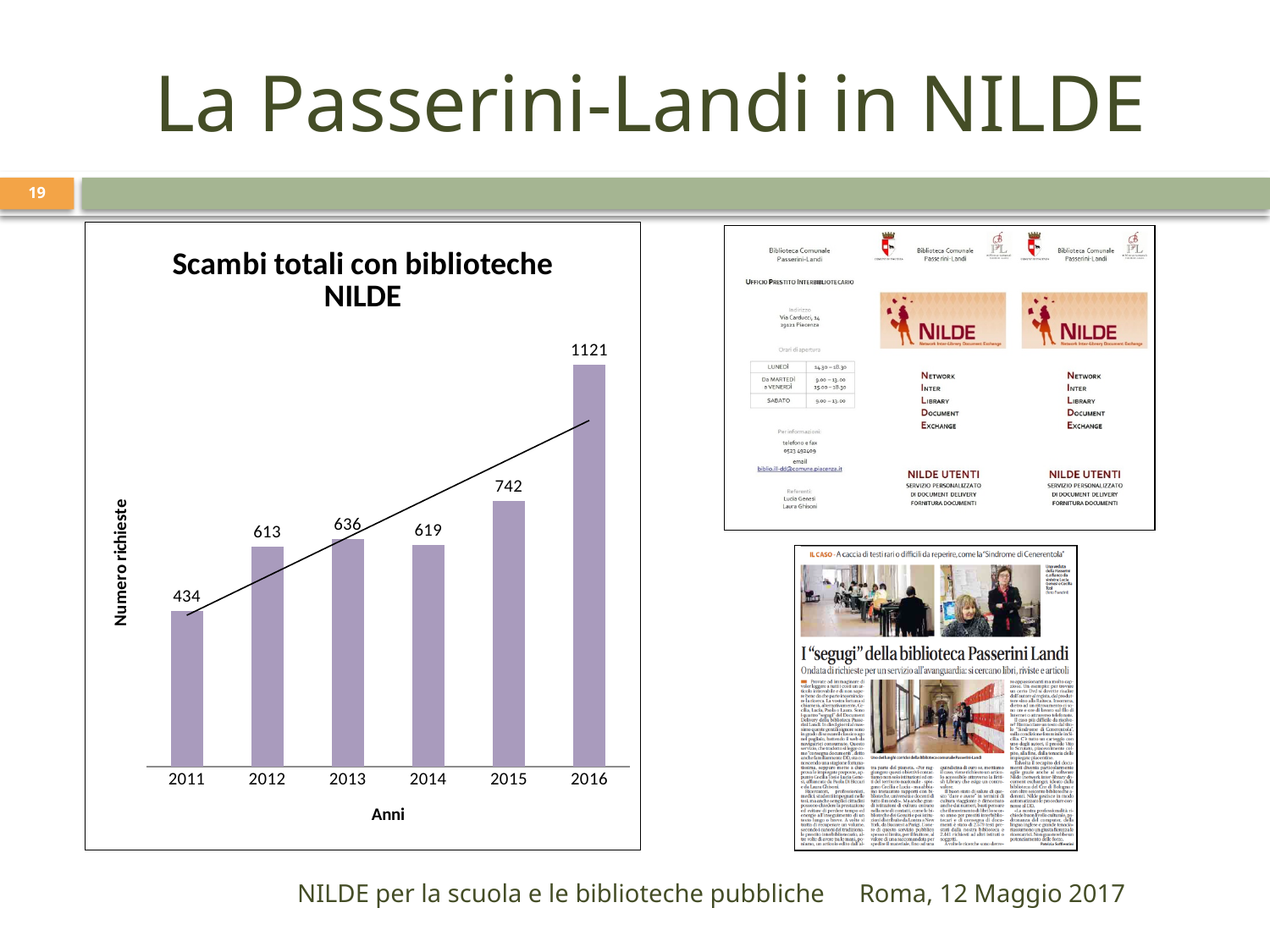
What is the label of the y axis in the chart 'Scambi totali con biblioteche NILDE'? Numero richieste What is the label of the x axis in the chart 'Scambi totali con biblioteche NILDE'? Anni What is the difference between the values for 2012 and 2011 in the chart 'Scambi totali con biblioteche NILDE'? 179 Which year has the lowest value in the chart 'Scambi totali con biblioteche NILDE'? 2011 In the chart 'Scambi totali con biblioteche NILDE', which is larger, the value for 2013 or the value for 2014? 2013 How many years are shown on the x axis of the chart 'Scambi totali con biblioteche NILDE'? 6 What is the value for 2016 in the chart 'Scambi totali con biblioteche NILDE'? 1121 What is the difference between the values for 2016 and 2015 in the chart 'Scambi totali con biblioteche NILDE'? 379 Which year has the highest value in the chart 'Scambi totali con biblioteche NILDE'? 2016 What is the value for 2011 in the chart 'Scambi totali con biblioteche NILDE'? 434 What kind of chart is 'Scambi totali con biblioteche NILDE'? bar chart What is the value for 2014 in the chart 'Scambi totali con biblioteche NILDE'? 619